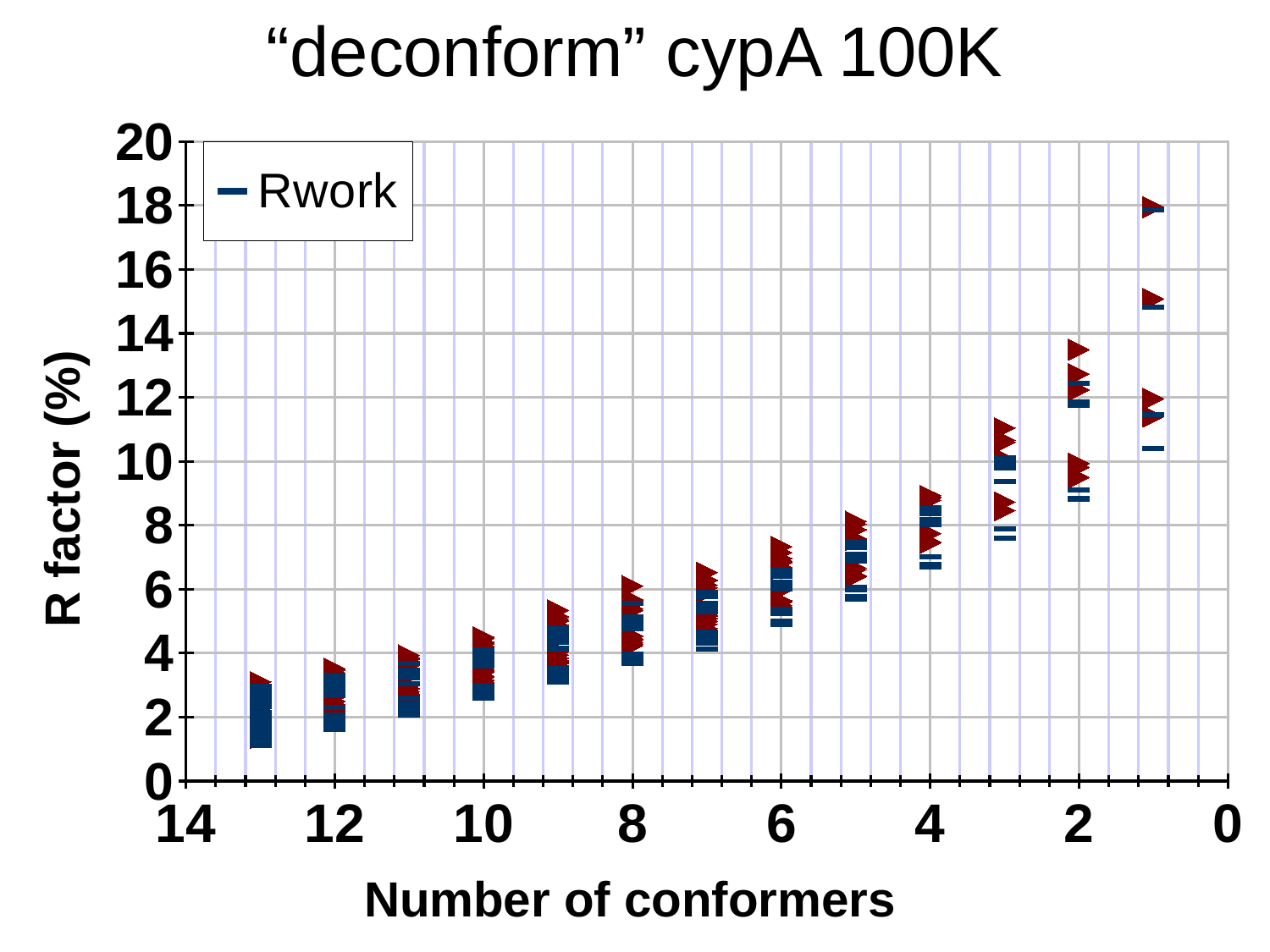
How many series does the legend list? 1 At which number of conformers are the lowest R factor values plotted? 13 What kind of chart is shown on the slide? scatter chart Are the Rwork values at 4 conformers greater or less than 10? less What is the title of the chart? “deconform” cypA 100K Are the Rwork values at 8 conformers greater or less than 2? greater At which number of conformers are the highest R factor values plotted? 1 Is the highest plotted value at 1 conformer greater or less than 16? greater Moving from left to right along the x axis (from 14 conformers toward 0), do the R factor values rise or fall? rise What is the label of the y axis? R factor (%) Which has larger Rwork values: 1 conformer or 13 conformers? 1 conformer